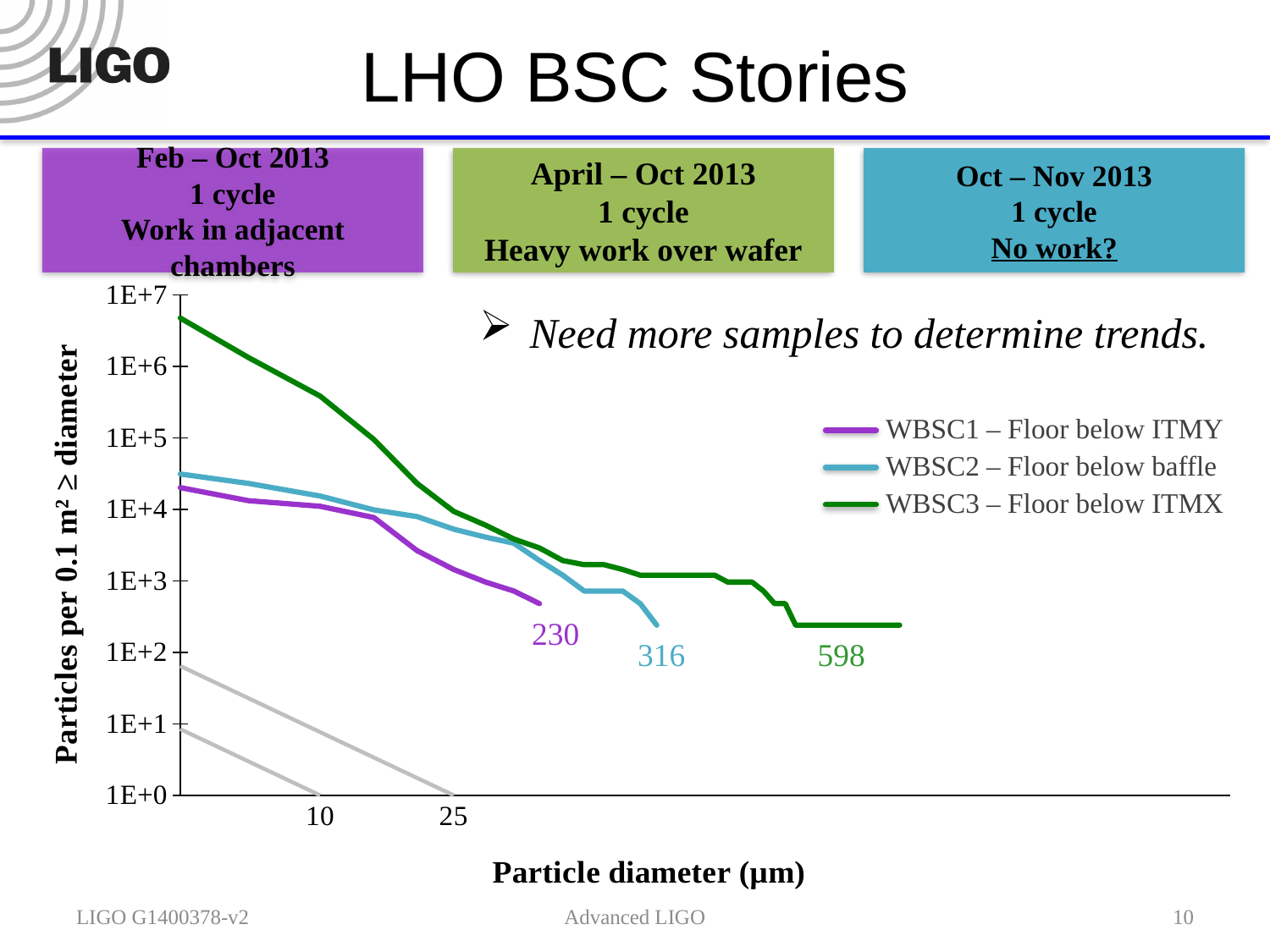
At the smallest particle diameter, is the value for WBSC1 – Floor below ITMY greater or less than 1E+5? less At the smallest particle diameter, is the value for WBSC2 – Floor below baffle greater or less than 1E+4? greater What kind of chart is shown on the slide? line chart Which series is drawn in green? WBSC3 – Floor below ITMX What number is printed at the end of the WBSC1 – Floor below ITMY line? 230 At the smallest particle diameter, is the value for WBSC3 – Floor below ITMX greater or less than 1E+6? greater How many series does the chart legend list? 3 What number is printed at the end of the WBSC3 – Floor below ITMX line? 598 Which series has the highest particle count at the smallest particle diameter? WBSC3 – Floor below ITMX Do the particle counts rise or fall as particle diameter increases along the x axis? fall What is the title of the chart's y axis? Particles per 0.1 m² ≥ diameter At a particle diameter of 10 µm, which series has the larger value: WBSC3 – Floor below ITMX or WBSC1 – Floor below ITMY? WBSC3 – Floor below ITMX